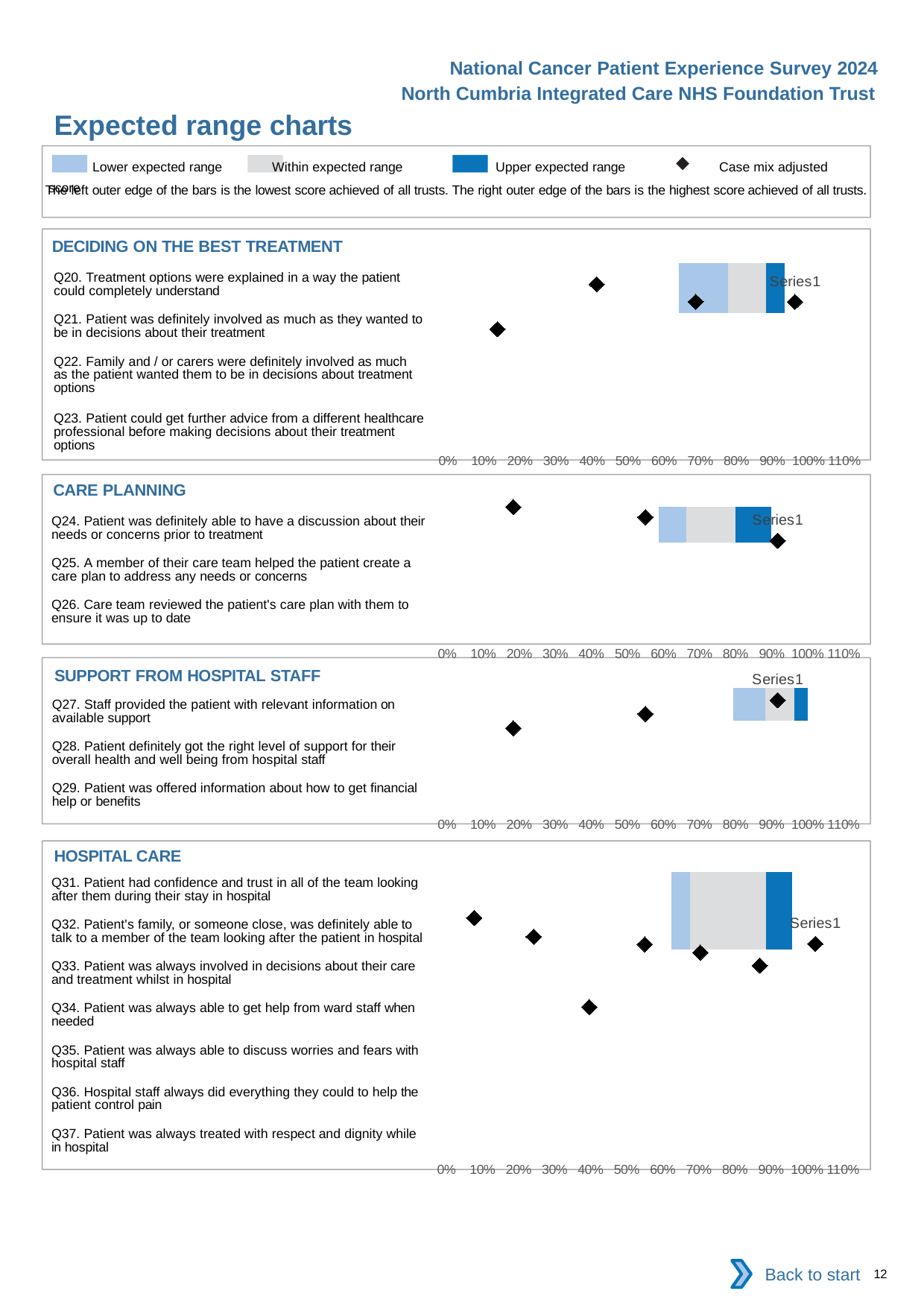
What is the highest tick value shown on the x axis of the 'HOSPITAL CARE' chart? 110% Which question label comes first in the 'CARE PLANNING' chart? Q24. Patient was definitely able to have a discussion about their needs or concerns prior to treatment What kind of chart is used in the 'DECIDING ON THE BEST TREATMENT' section? Bar chart What is the main title of the slide? Expected range charts How many questions (categories) are listed in the 'CARE PLANNING' chart? 3 How many questions (categories) are listed in the 'HOSPITAL CARE' chart? 7 According to the legend, which colour represents the 'Upper expected range'? Dark blue How many entries does the legend at the top of the slide list? 4 How many questions (categories) are listed in the 'SUPPORT FROM HOSPITAL STAFF' chart? 3